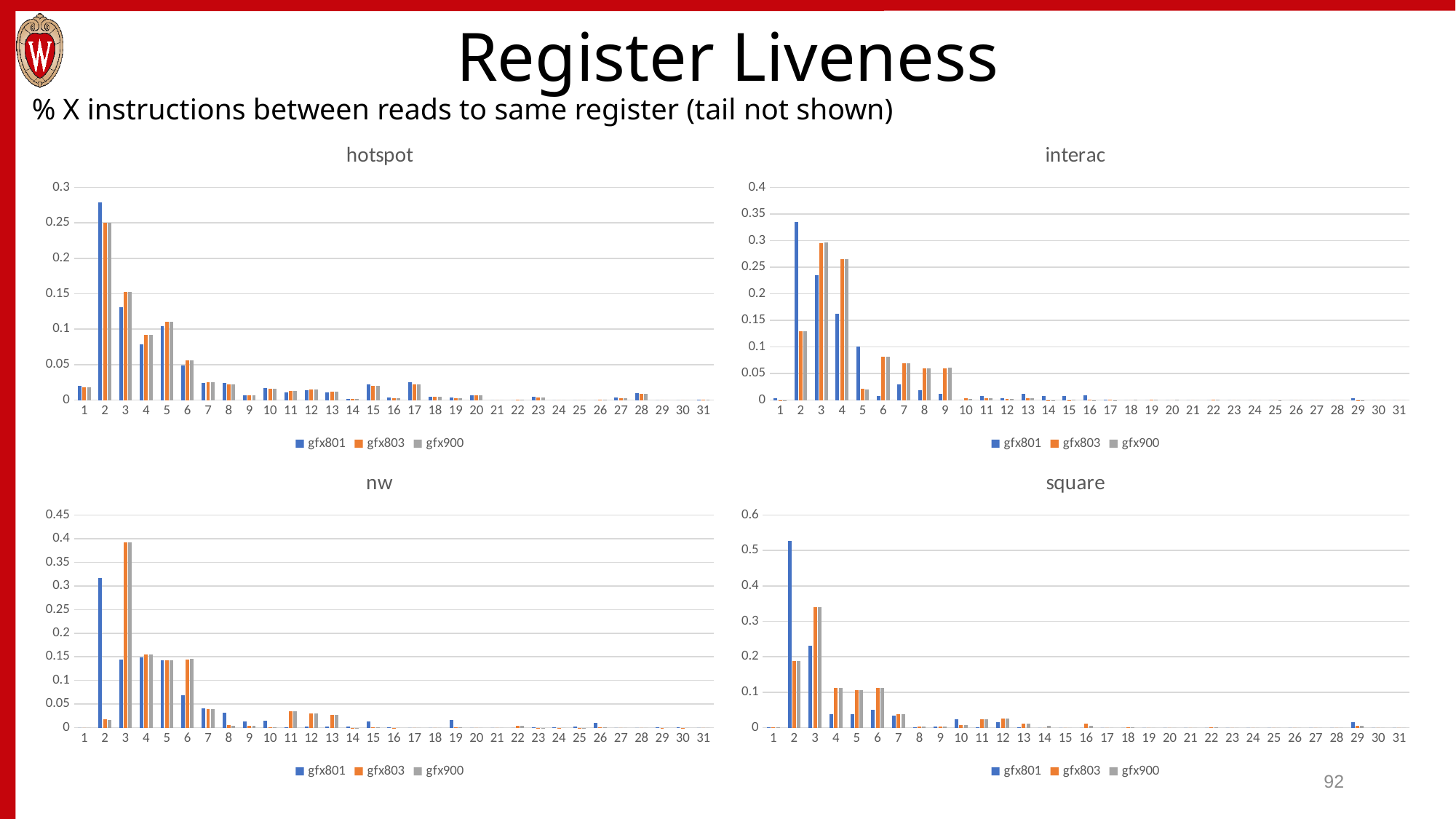
In the interac chart, is the value for gfx900 at category 2 greater or less than 0.15? less What kind of chart is the hotspot chart? bar chart In the hotspot chart, is the value for gfx801 at category 2 greater or less than 0.25? greater In the nw chart, which series has the tallest bar overall? gfx803 and gfx900 (tied) In the square chart, is the value for gfx801 at category 2 greater or less than 0.5? greater In the interac chart, at category 2, which is larger: gfx801 or gfx900? gfx801 How many series does the legend of the interac chart list? 3 How many categories are shown on the x axis of the nw chart? 31 In the square chart, at which category does gfx801 reach its highest value? 2 What are the three legend entries in the square chart? gfx801, gfx803, gfx900